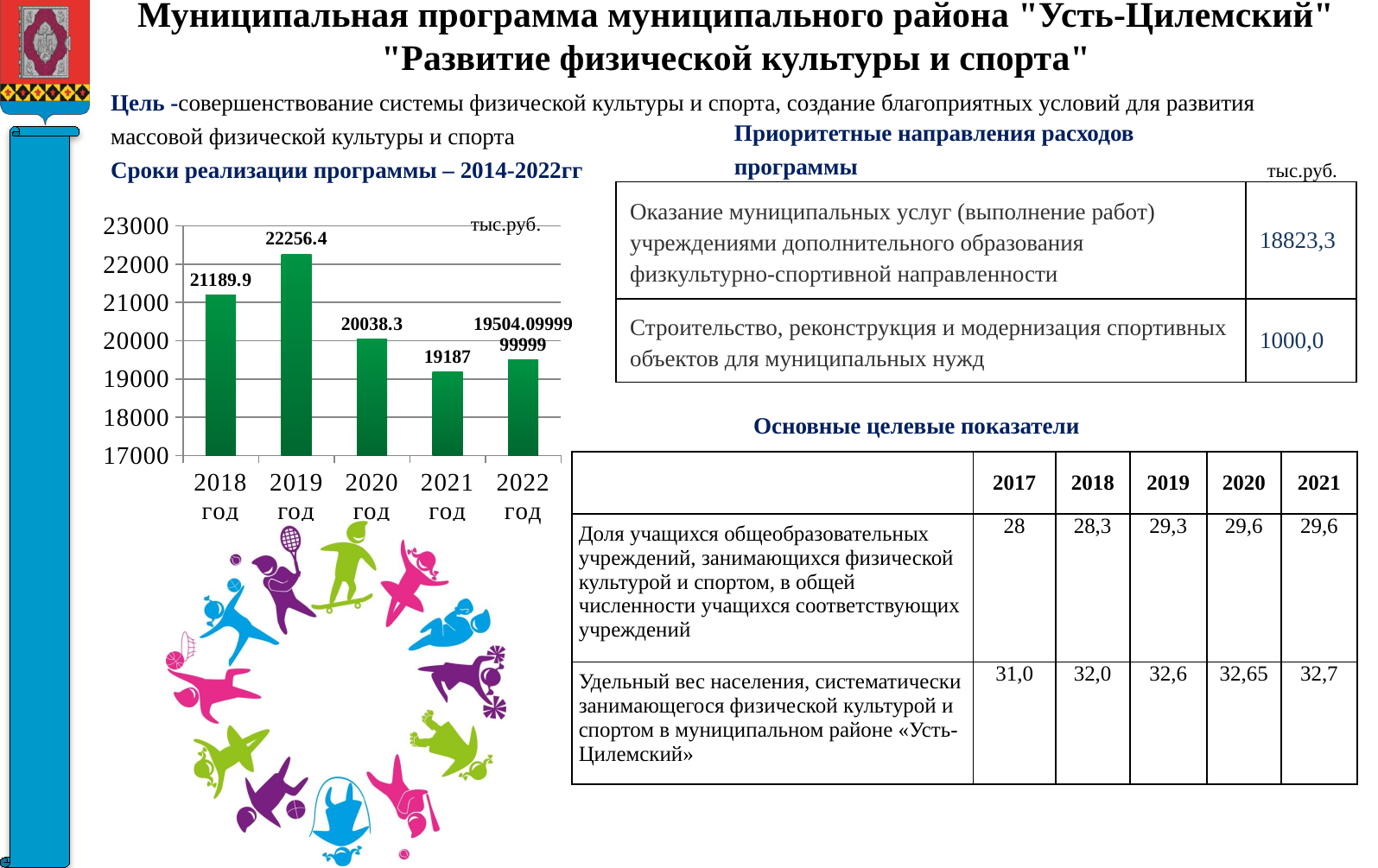
What is the value for 2021 год in the chart? 19187 Is the value for 2022 год greater or less than 20000? less What type of chart is shown on the slide? bar chart What is the difference between the values for 2019 год and 2018 год? 1066.5 Which year has the lowest value in the chart? 2021 год What is the value for 2019 год in the chart? 22256.4 What unit is indicated in the top right corner of the chart? тыс.руб. Which year has the highest value in the chart? 2019 год What is the value for 2018 год in the chart? 21189.9 What is the value for 2020 год in the chart? 20038.3 How many bars (years) does the chart show? 5 Which is larger, the value for 2020 год or the value for 2022 год? 2020 год